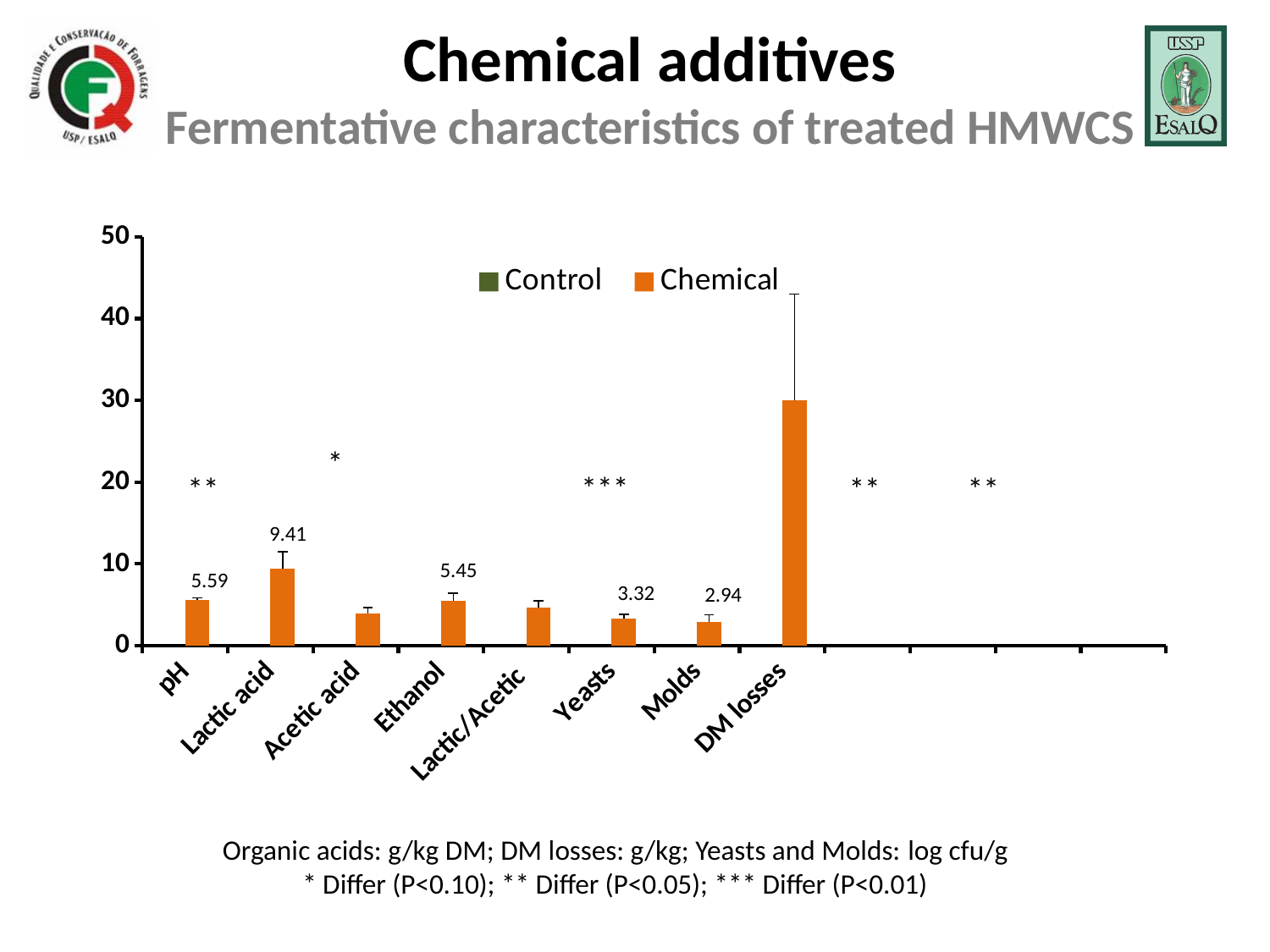
What is the Chemical value for Yeasts? 3.32 How many labeled categories are on the x axis? 8 What is the Chemical value for Ethanol? 5.45 What is the Chemical value for Lactic acid? 9.41 How many series does the legend list? 2 What are the two series named in the legend? Control and Chemical Which category has the tallest Chemical bar? DM losses What type of chart is shown on the slide? bar chart Is the Chemical value for DM losses greater or less than 20? greater What is the Chemical value for Molds? 2.94 What is the difference between the Chemical values for Lactic acid and Ethanol? 3.96 What is the Chemical value for pH? 5.59